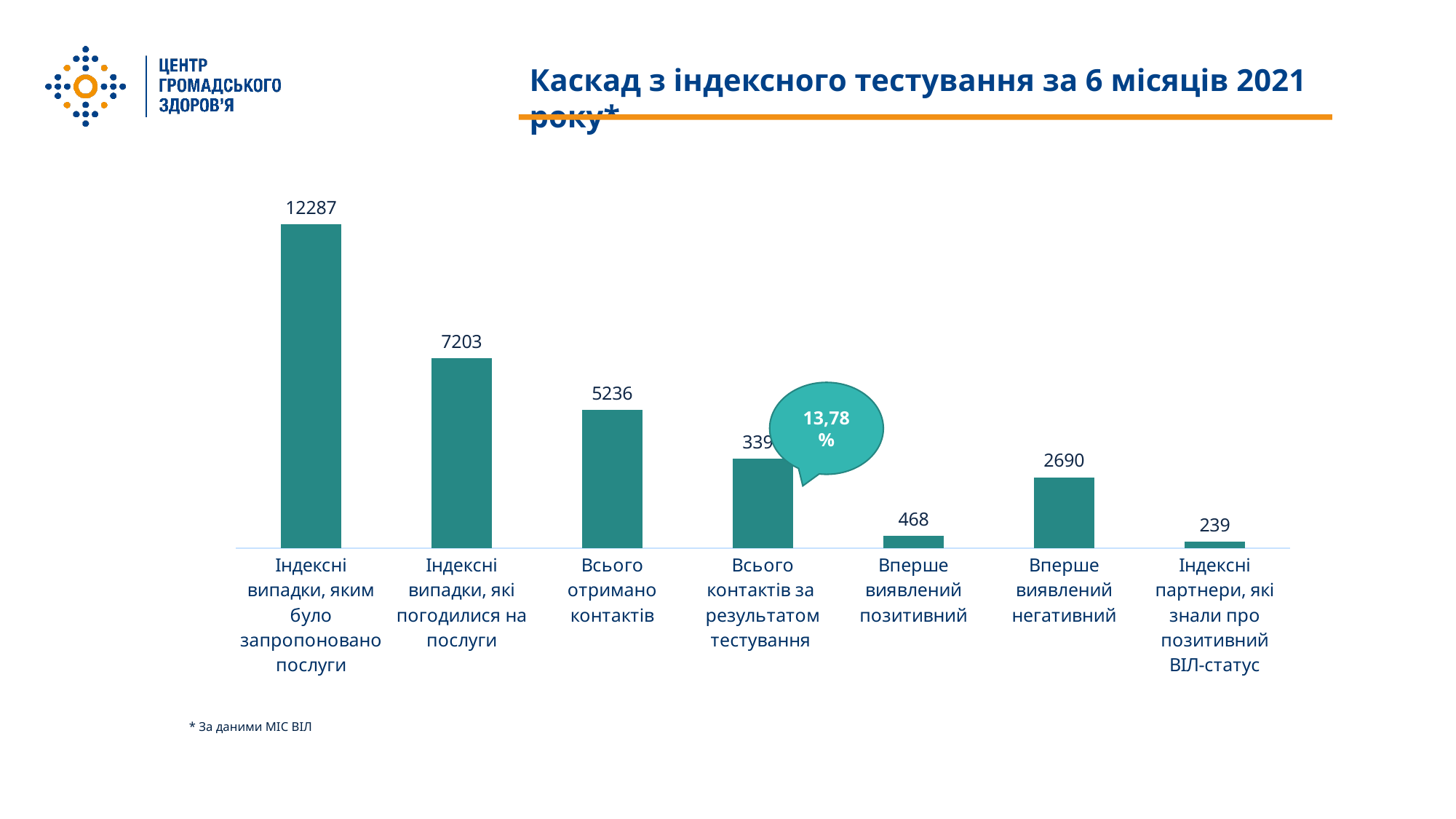
Which is larger: "Вперше виявлений позитивний" or "Вперше виявлений негативний"? Вперше виявлений негативний How many categories are shown in the chart? 7 What is the value for "Вперше виявлений негативний"? 2690 What is the value for "Індексні випадки, яким було запропоновано послуги"? 12287 What is the value for "Всього отримано контактів"? 5236 Which category has the lowest value? Індексні партнери, які знали про позитивний ВІЛ-статус Which category has the highest value? Індексні випадки, яким було запропоновано послуги What is the difference between "Індексні випадки, яким було запропоновано послуги" and "Індексні випадки, які погодилися на послуги"? 5084 What is the value for "Індексні партнери, які знали про позитивний ВІЛ-статус"? 239 What is the value for "Індексні випадки, які погодилися на послуги"? 7203 What type of chart is shown on the slide? Bar chart What is the value for "Вперше виявлений позитивний"? 468